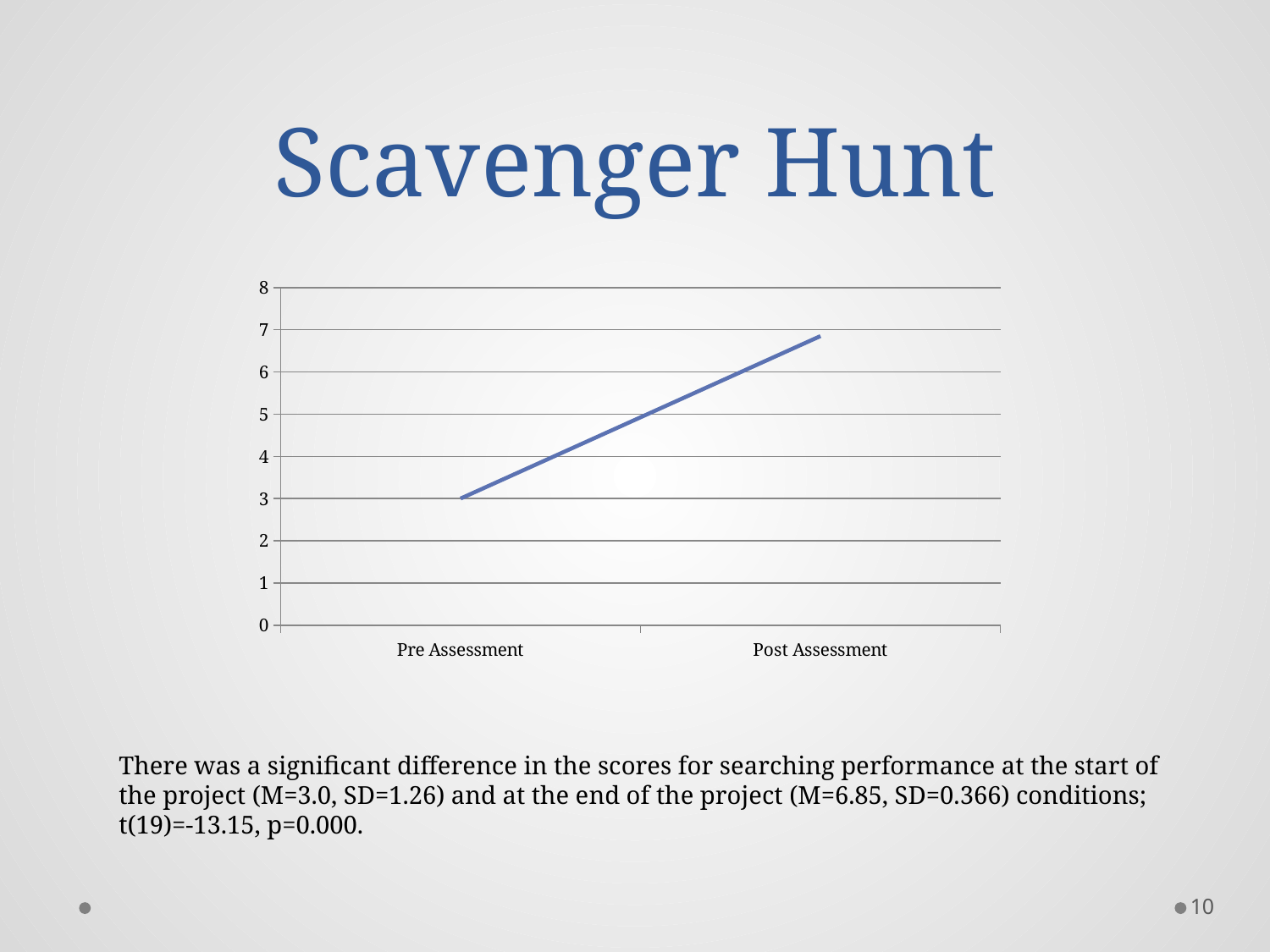
What is the title of the slide containing the chart? Scavenger Hunt Is the value for Post Assessment greater or less than 6? greater Which is larger, the value for Pre Assessment or Post Assessment? Post Assessment Do the values rise or fall from Pre Assessment to Post Assessment? rise Which category has the highest value? Post Assessment What is the value for Pre Assessment? 3 Is the value for Pre Assessment greater or less than 4? less Which category has the lowest value? Pre Assessment Is the value for Post Assessment greater or less than 7? less How many categories are plotted on the x axis? 2 What is the highest tick value shown on the y axis? 8 What kind of chart is shown on the slide? line chart